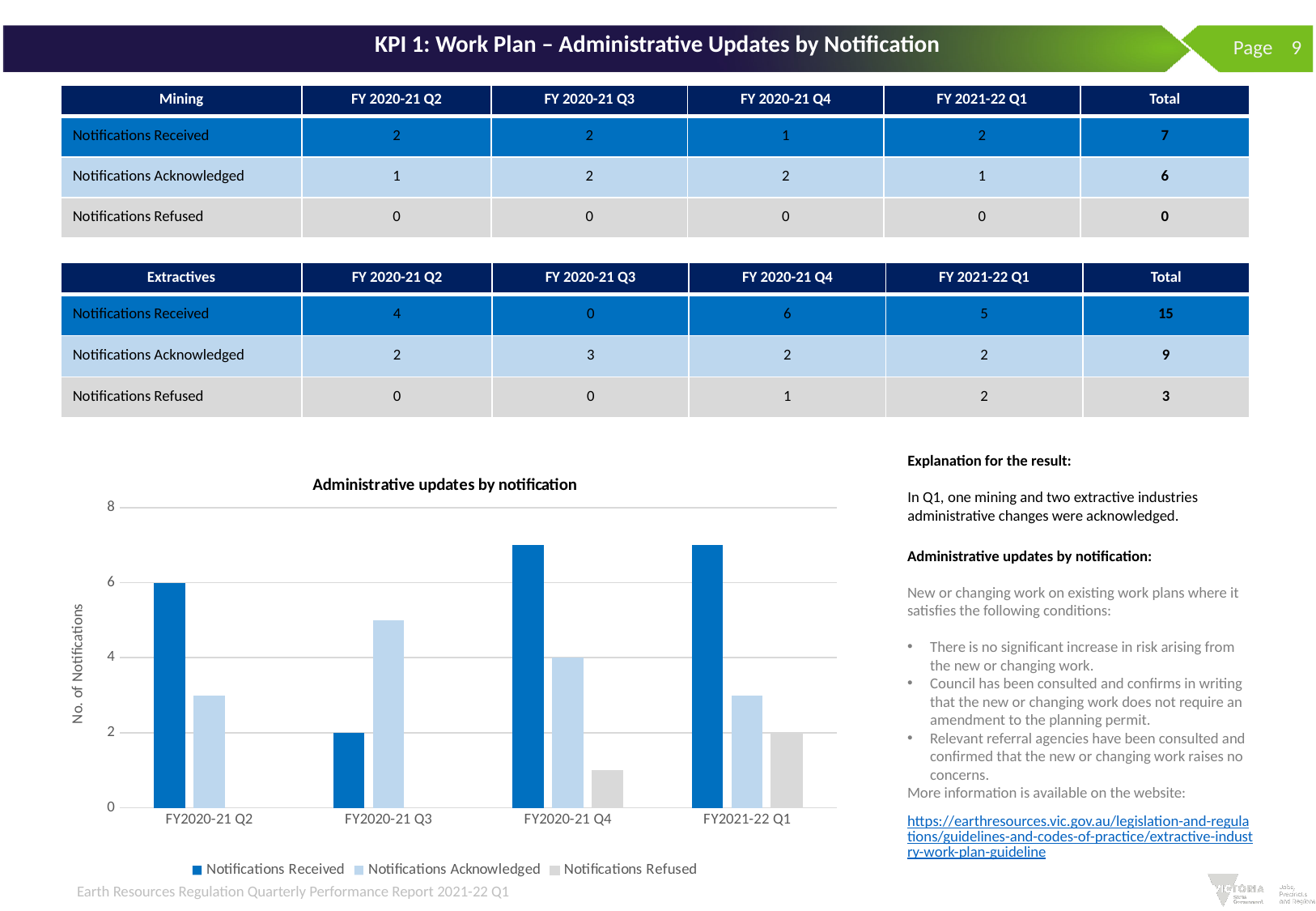
In FY2020-21 Q2, which is larger: Notifications Received or Notifications Acknowledged? Notifications Received What kind of chart is shown on the slide? bar chart What is the value of Notifications Received for FY2020-21 Q2 in the chart? 6 What is the value of Notifications Refused for FY2021-22 Q1 in the chart? 2 Is the value for Notifications Received in FY2020-21 Q4 greater or less than 6? greater How many series does the chart's legend list? 3 How many quarters are shown on the x axis of the chart? 4 What is the value of Notifications Acknowledged for FY2020-21 Q4 in the chart? 4 Which quarter has the highest value for Notifications Acknowledged? FY2020-21 Q3 What is the difference between Notifications Received in FY2020-21 Q2 and FY2020-21 Q3? 4 What is the value of Notifications Received for FY2020-21 Q3 in the chart? 2 Which quarter has the lowest value for Notifications Received? FY2020-21 Q3